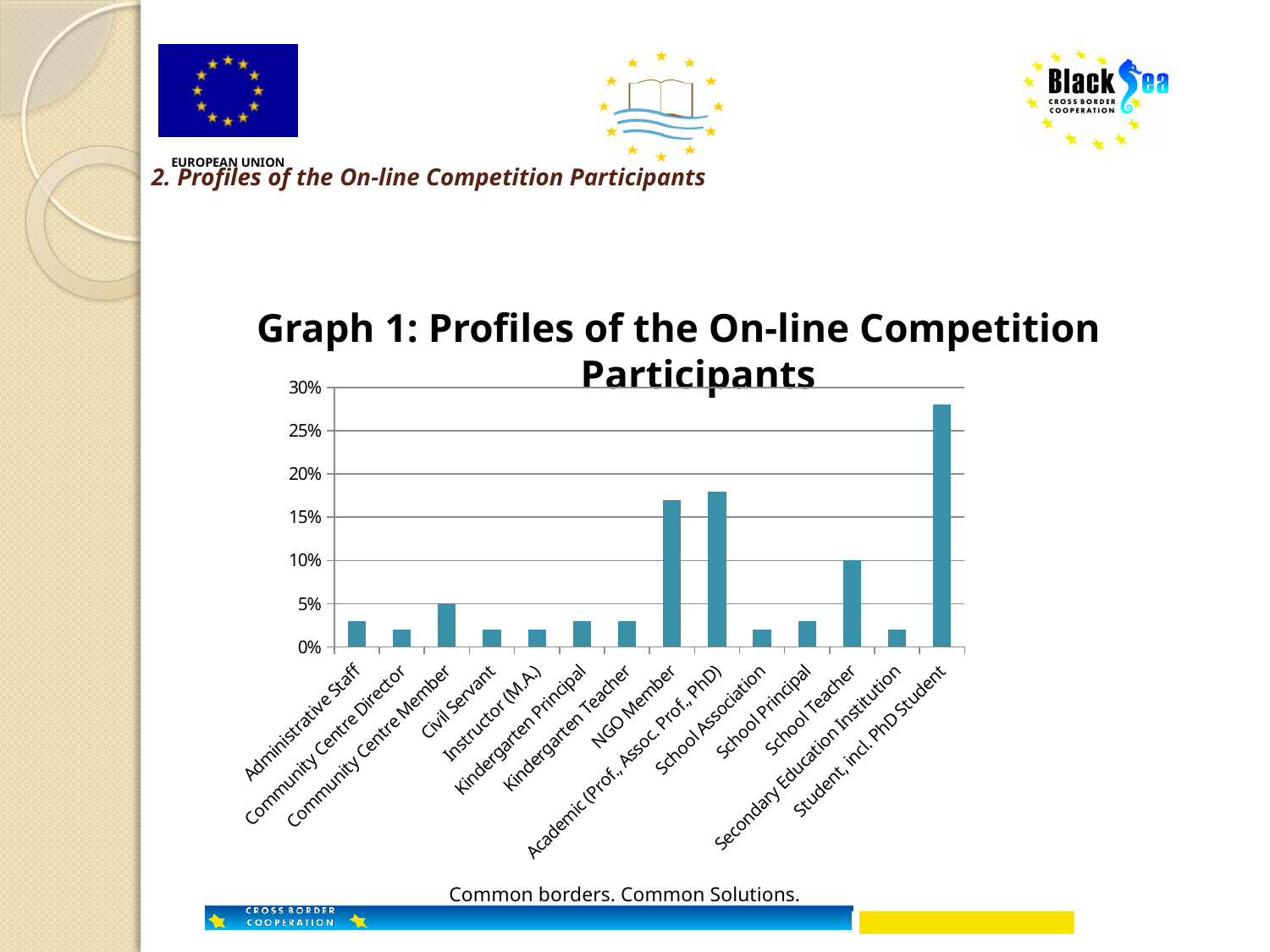
Which category has the highest value? Student, incl. PhD Student What is the value for School Teacher? 10% Which is larger, the value for Student, incl. PhD Student or the value for Academic (Prof., Assoc. Prof., PhD)? Student, incl. PhD Student What is the value for Community Centre Member? 5% Is the value for Administrative Staff greater or less than 5%? less How many participant categories are shown on the x axis? 14 What is the title of the chart? Graph 1: Profiles of the On-line Competition Participants Is the value for Student, incl. PhD Student greater or less than 25%? greater Is the value for NGO Member greater or less than 15%? greater What type of chart is shown on the slide? bar chart Which is larger, the value for School Teacher or the value for School Principal? School Teacher